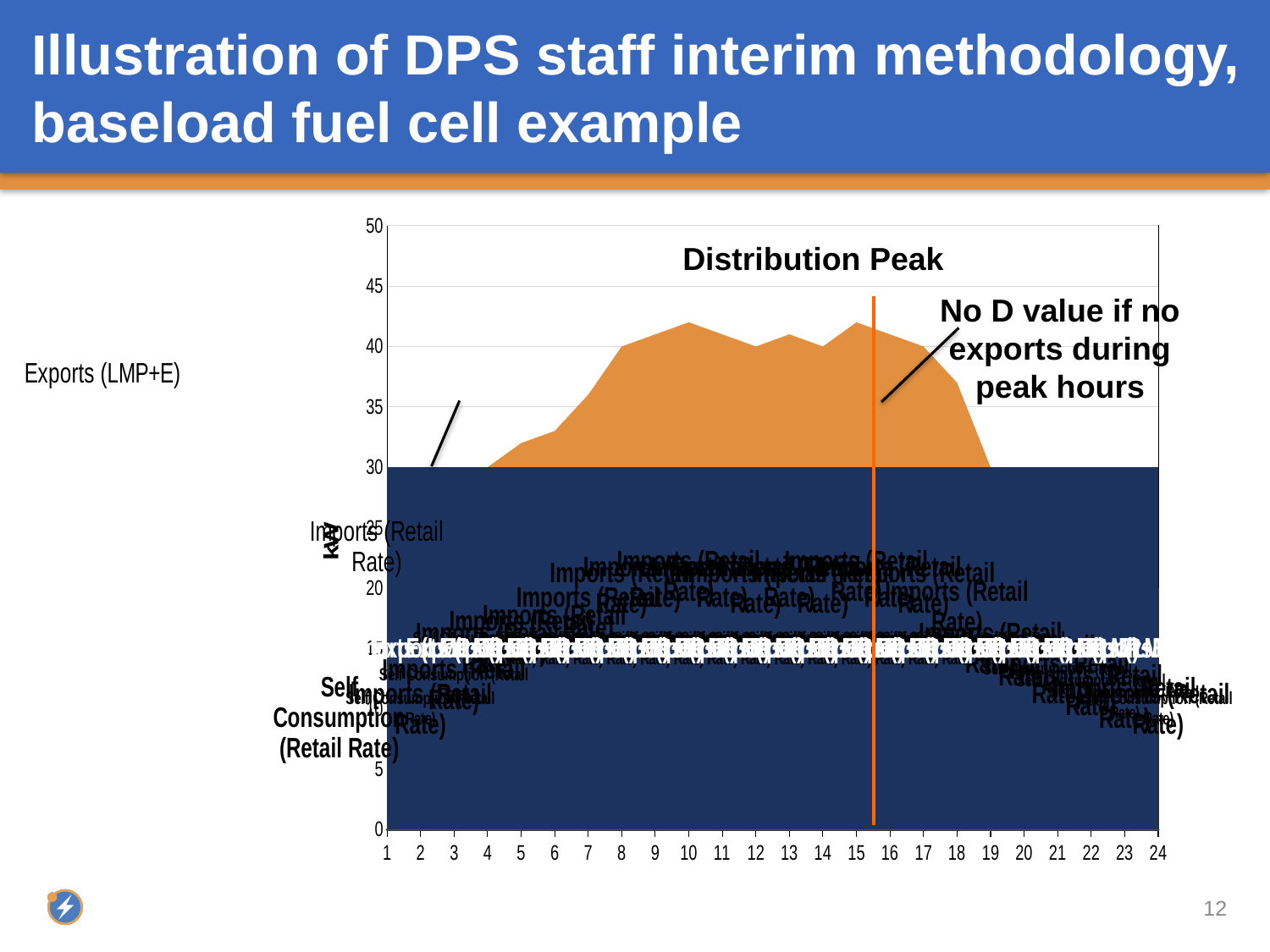
Is the total value at hour 2 greater or less than 35? less Is the total value at hour 15 greater or less than 40? greater How many hourly points are shown along the x axis of the chart? 24 Is the total value at hour 22 greater or less than 35? less What text is written above the orange vertical line in the chart? Distribution Peak What kind of chart is shown on the slide? Area chart What is the label on the vertical axis of the chart? kW Do the total values rise or fall from hour 4 to hour 10? rise Do the total values rise or fall from hour 15 to hour 20? fall